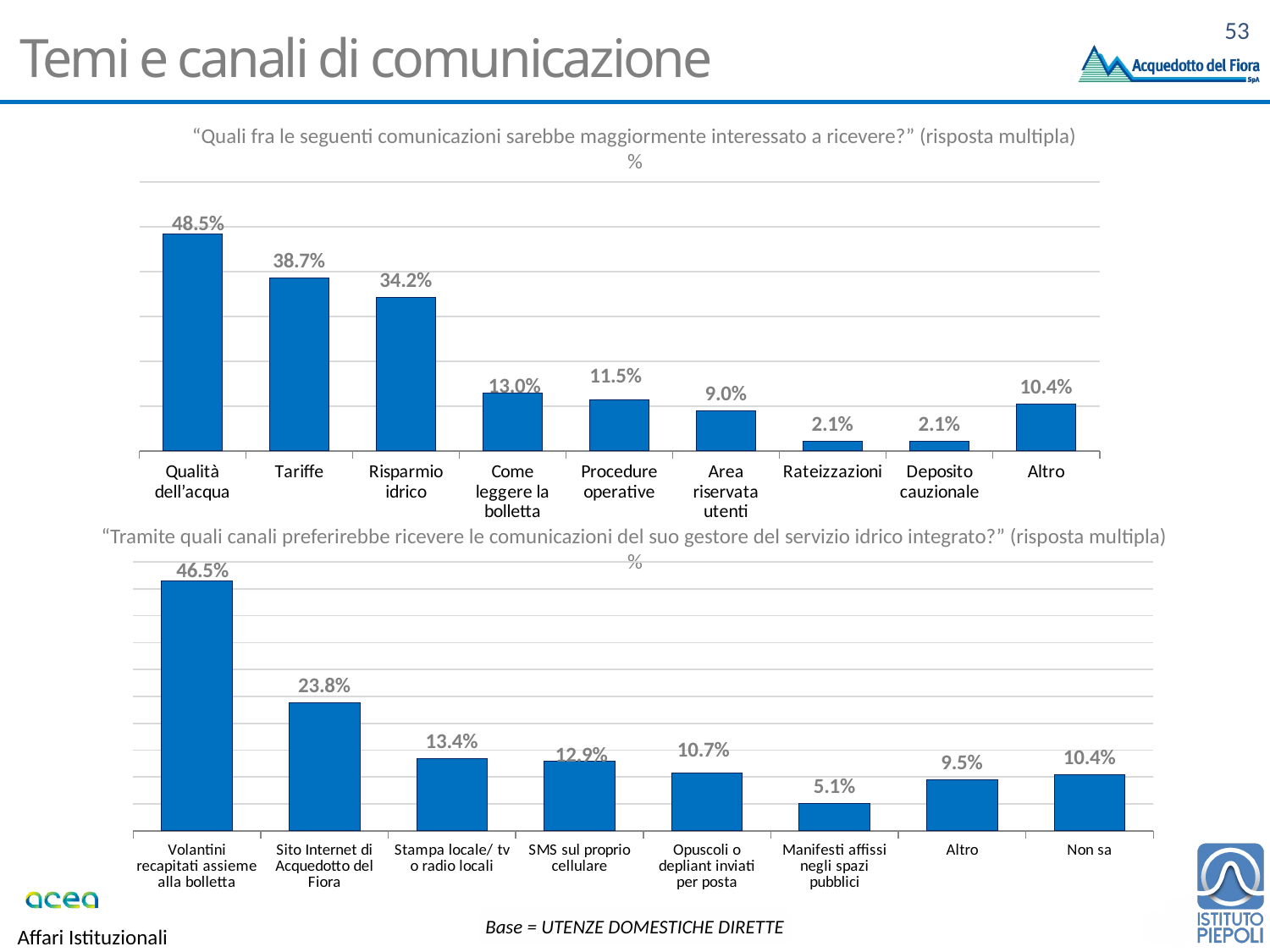
In the bottom chart, what is the value for Manifesti affissi negli spazi pubblici? 5.1% What type of chart is the bottom chart? Bar chart In the top chart, which is larger: Come leggere la bolletta or Procedure operative? Come leggere la bolletta In the bottom chart, what is the value for Sito Internet di Acquedotto del Fiora? 23.8% In the bottom chart, which category has the lowest value? Manifesti affissi negli spazi pubblici In the bottom chart, what is the difference between Volantini recapitati assieme alla bolletta and Sito Internet di Acquedotto del Fiora? 22.7% In the top chart, what is the value for Area riservata utenti? 9.0% In the top chart, which category has the highest value? Qualità dell'acqua In the top chart, what is the difference between Qualità dell'acqua and Risparmio idrico? 14.3% How many categories are shown in the bottom chart? 8 How many categories are shown in the top chart? 9 In the top chart, what is the value for Tariffe? 38.7%